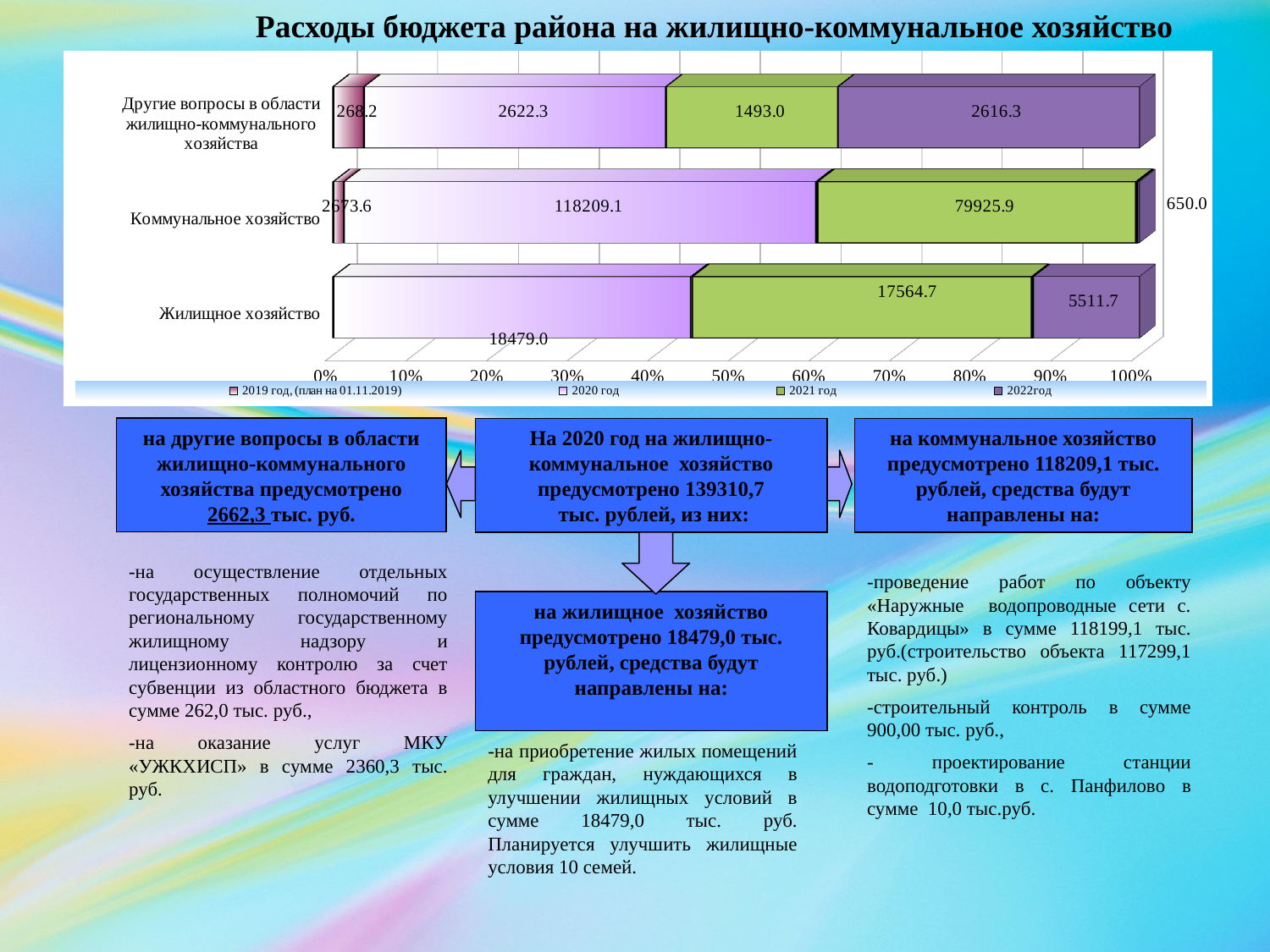
What is the value for Коммунальное хозяйство in the 2022год series? 650.0 What is the value for Другие вопросы в области жилищно-коммунального хозяйства in the 2022год series? 2616.3 What is the value for Другие вопросы в области жилищно-коммунального хозяйства in the 2019 год (план на 01.11.2019) series? 268.2 How many series does the legend list? 4 What is the value for Жилищное хозяйство in the 2020 год series? 18479.0 For Жилищное хозяйство, which is larger: the 2021 год value or the 2022год value? 2021 год How many categories are shown on the chart? 3 What is the difference between the 2020 год and 2021 год values for Жилищное хозяйство? 914.3 Which series has the highest value for Коммунальное хозяйство? 2020 год What is the difference between the 2020 год and 2021 год values for Другие вопросы в области жилищно-коммунального хозяйства? 1129.3 What is the value for Жилищное хозяйство in the 2021 год series? 17564.7 What is the value for Коммунальное хозяйство in the 2020 год series? 118209.1